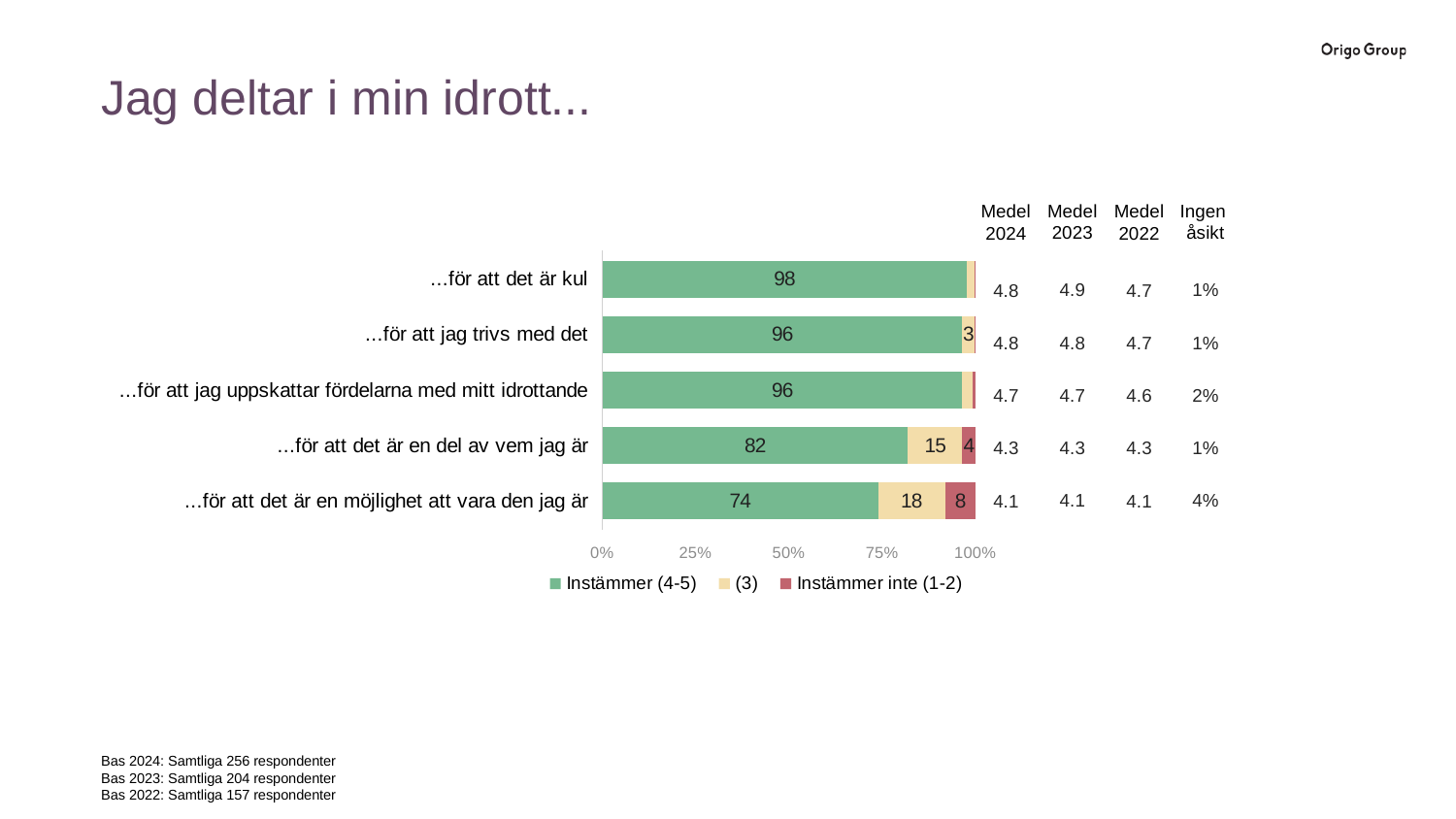
What is the value of "Instämmer inte (1-2)" for "...för att det är en möjlighet att vara den jag är"? 8 What type of chart is shown on the slide? Stacked bar chart Which has a larger "Instämmer (4-5)" value: "...för att det är en del av vem jag är" or "...för att det är en möjlighet att vara den jag är"? ...för att det är en del av vem jag är What is the value of "Instämmer (4-5)" for "...för att det är en möjlighet att vara den jag är"? 74 Which category has the highest "Instämmer (4-5)" value? ...för att det är kul What is the value of "Instämmer (4-5)" for "...för att det är kul"? 98 What is the value of "(3)" for "...för att det är en del av vem jag är"? 15 Which category has the lowest "Instämmer (4-5)" value? ...för att det är en möjlighet att vara den jag är How many categories are shown in the chart? 5 What is the difference between the "Instämmer (4-5)" values for "...för att det är kul" and "...för att det är en möjlighet att vara den jag är"? 24 How many series does the legend list? 3 Is the "(3)" value for "...för att det är kul" greater or less than 25? less